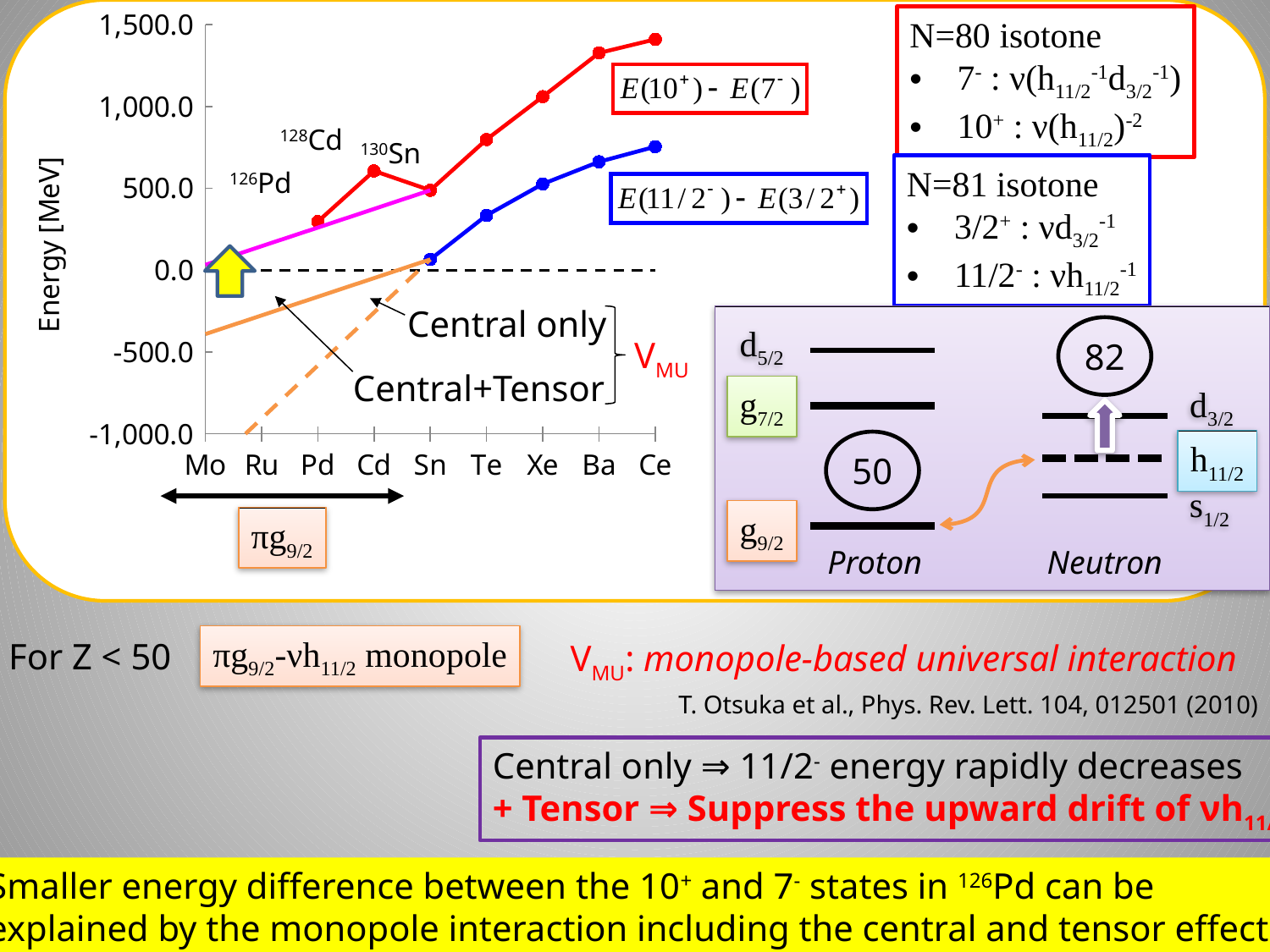
At Te, which series has the larger value: E(10+) - E(7-) or E(11/2-) - E(3/2+)? E(10+) - E(7-) Is the value of the E(11/2-) - E(3/2+) series at Sn greater or less than 500.0? less Is the value of the E(10+) - E(7-) series at Ce greater or less than 1,000.0? greater What kind of chart is shown on the slide? line chart Is the value of the E(10+) - E(7-) series at Ba greater or less than 1,000.0? greater Does the E(11/2-) - E(3/2+) series rise or fall from Sn to Ce? rise What is the label of the y axis of the chart? Energy [MeV] At which element does the E(10+) - E(7-) series reach its highest value? Ce How many element categories are listed along the x axis of the chart? 9 At which element does the E(11/2-) - E(3/2+) series have its lowest value? Sn